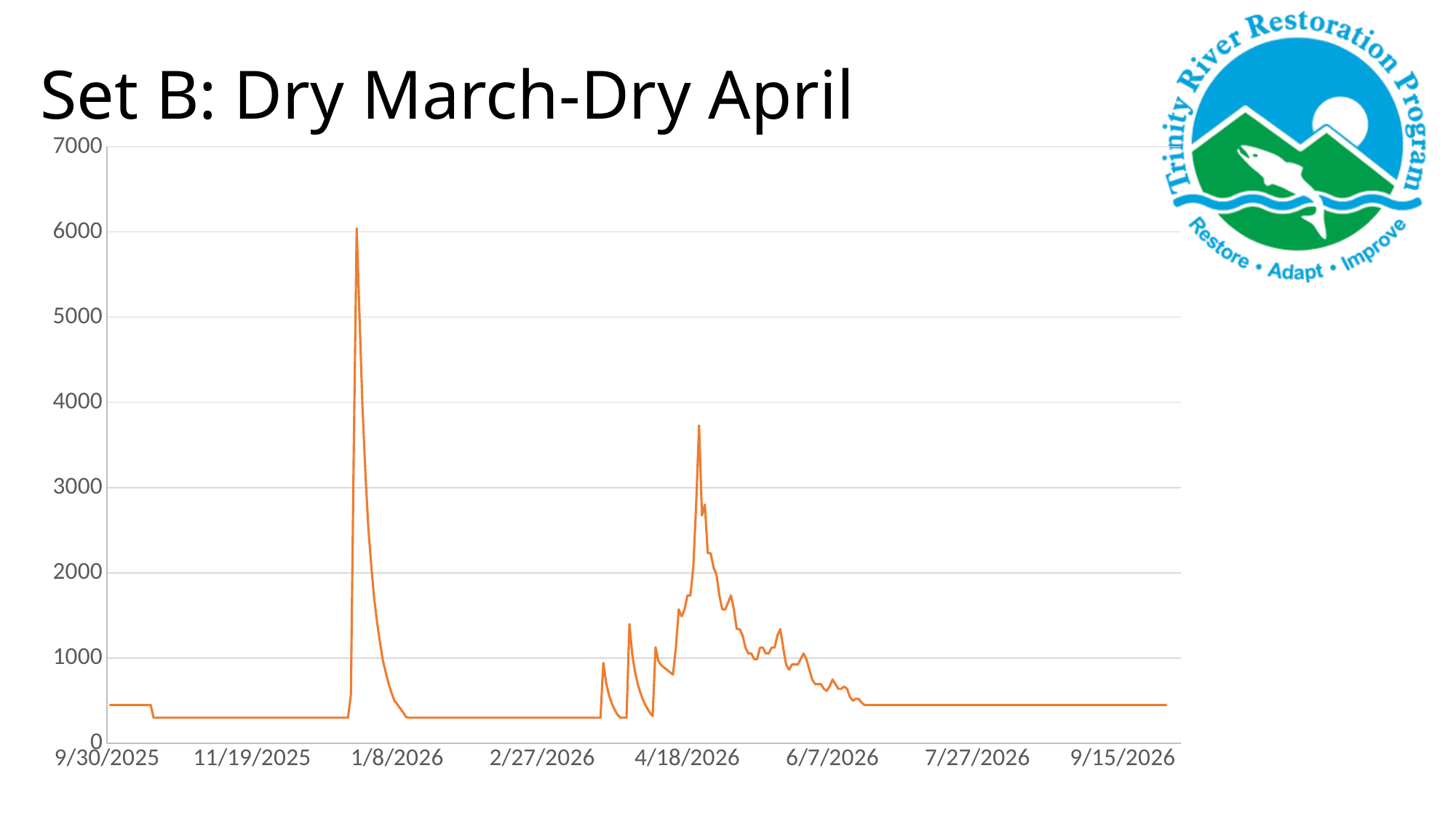
What kind of chart is shown on the slide? line chart Is the value of the line at 11/19/2025 greater or less than 1000? less What is the title of the chart on the slide? Set B: Dry March-Dry April Is the highest peak of the line greater or less than 5000? greater What colour is the plotted line? orange Which is larger: the peak of the line shortly before 1/8/2026 or the peak near 4/18/2026? the peak shortly before 1/8/2026 Does the line rise or fall overall between 4/18/2026 and 6/7/2026? fall Is the peak of the line near 4/18/2026 greater or less than 4000? less Near which x-axis date does the line reach its highest value? 1/8/2026